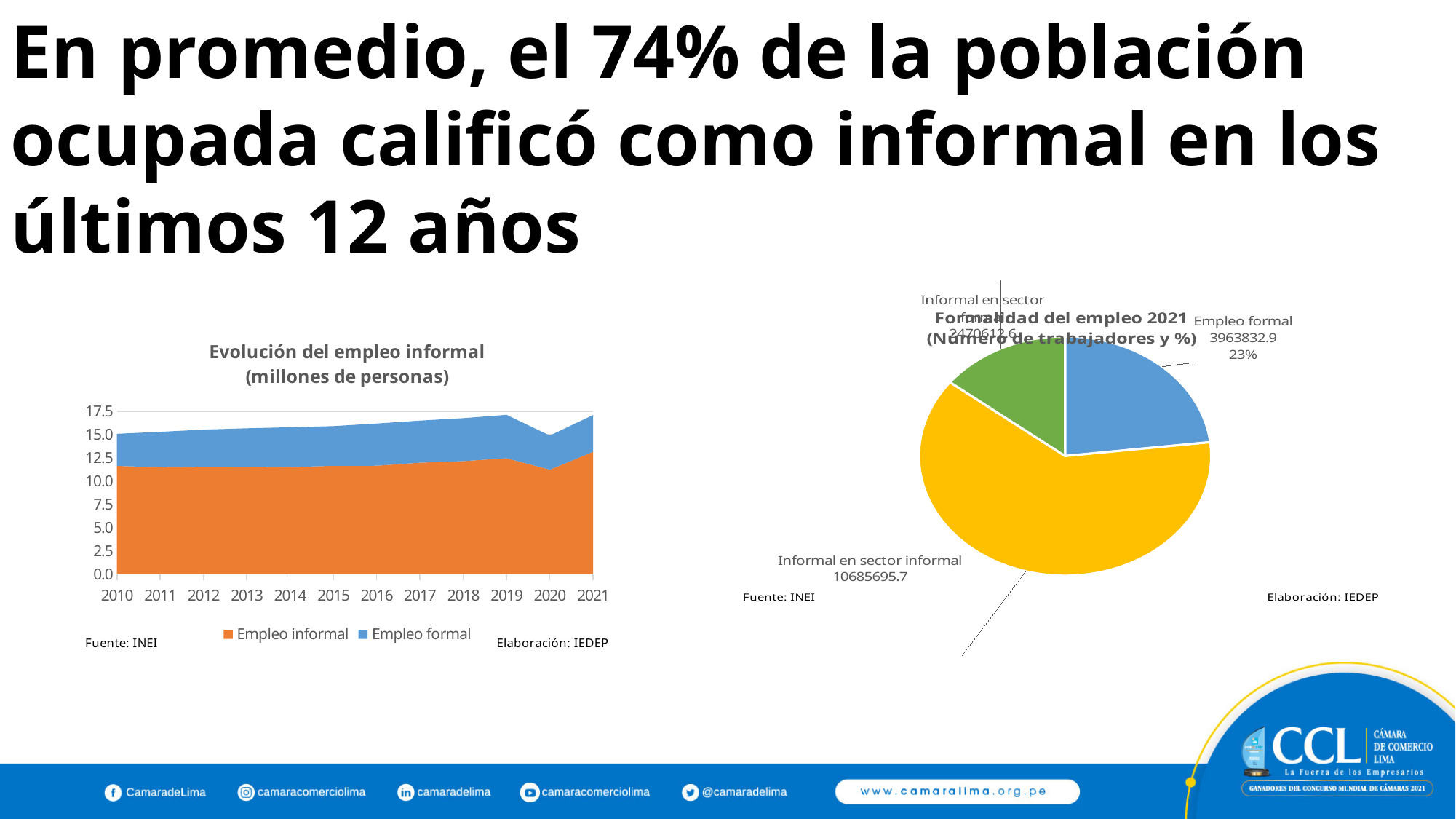
What kind of chart is 'Evolución del empleo informal (millones de personas)'? Area chart What kind of chart is 'Formalidad del empleo 2021 (Número de trabajadores y %)'? Pie chart How many series does the legend of the 'Evolución del empleo informal' chart list? 2 In the 'Formalidad del empleo 2021' pie chart, what is the difference between Informal en sector informal and Empleo formal? 6721862.8 In the 'Formalidad del empleo 2021' pie chart, what is the number of workers for Empleo formal? 3963832.9 How many years are shown on the x axis of the 'Evolución del empleo informal' chart? 12 In the 'Formalidad del empleo 2021' pie chart, which category has the largest slice? Informal en sector informal In the 'Evolución del empleo informal' chart, is the value for Empleo informal in 2010 greater or less than 10.0? greater In the 'Evolución del empleo informal' chart, is the combined total of both series in 2019 greater or less than 15.0? greater In the 'Evolución del empleo informal' chart, does the combined total of both series rise or fall from 2010 to 2019? rise In the 'Formalidad del empleo 2021' pie chart, what is the number of workers for Informal en sector informal? 10685695.7 In the 'Formalidad del empleo 2021' pie chart, what share of the pie is Empleo formal? 23%